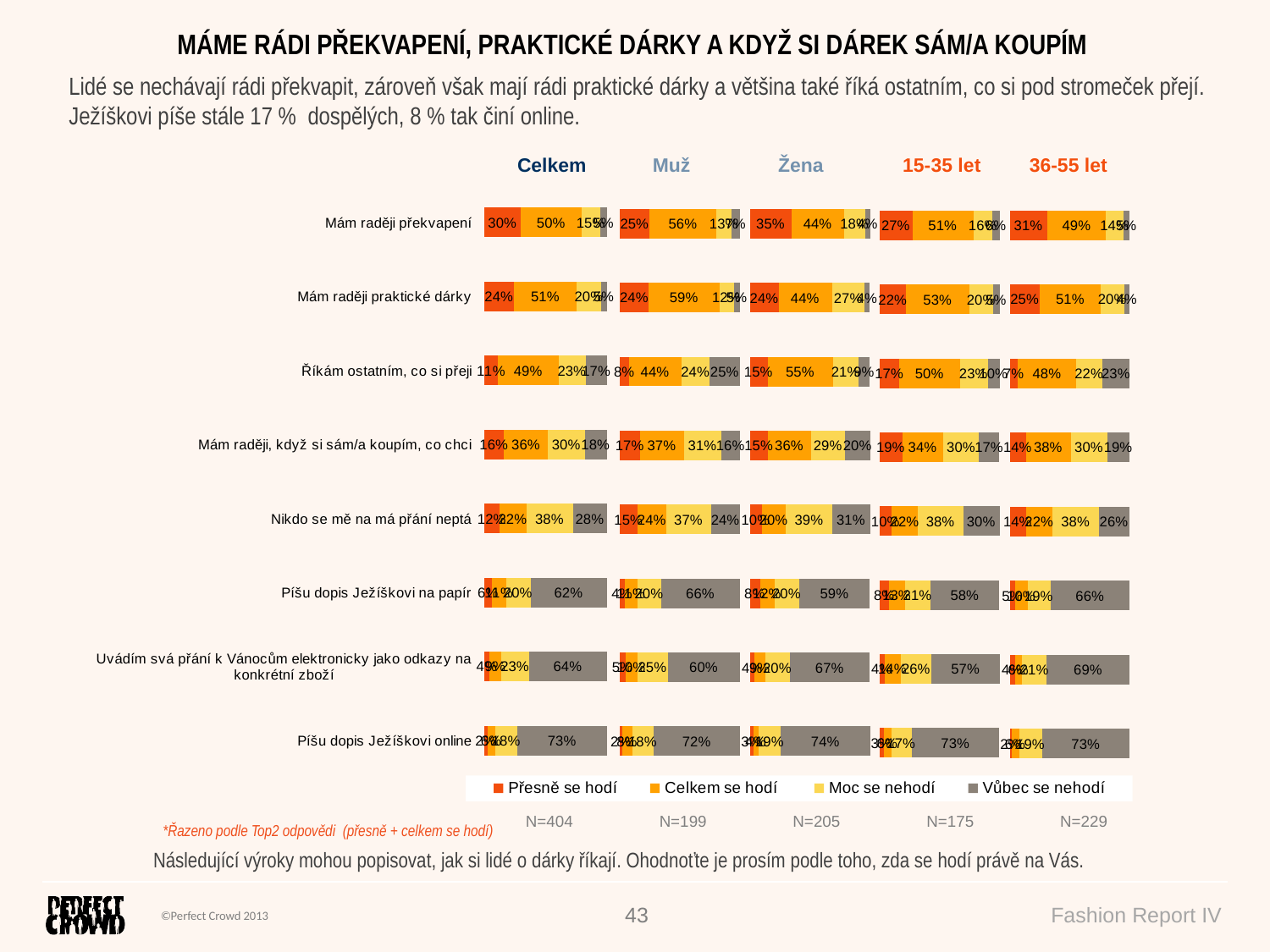
In the 15-35 let chart, what percentage answered "Vůbec se nehodí" for "Uvádím svá přání k Vánocům elektronicky jako odkazy na konkrétní zboží"? 57% In the Celkem chart, which statement has the highest "Vůbec se nehodí" share? Píšu dopis Ježíškovi online In the Celkem chart, what percentage answered "Přesně se hodí" for "Mám raději překvapení"? 30% In the Muž chart, what percentage answered "Celkem se hodí" for "Mám raději praktické dárky"? 59% In the Žena chart, what percentage answered "Vůbec se nehodí" for "Píšu dopis Ježíškovi online"? 74% What is the sample size (N) shown for the Celkem chart? N=404 In the 36-55 let chart, what percentage answered "Vůbec se nehodí" for "Píšu dopis Ježíškovi na papír"? 66% What kind of chart is used on this slide? Stacked bar chart How many series does the legend list? 4 Which is larger: the "Přesně se hodí" share for "Mám raději překvapení" in the Muž chart or in the Žena chart? Žena In the Celkem chart, what is the difference between the "Celkem se hodí" share for "Mám raději překvapení" and for "Mám raději, když si sám/a koupím, co chci"? 14% How many statements (categories) are shown in each chart? 8